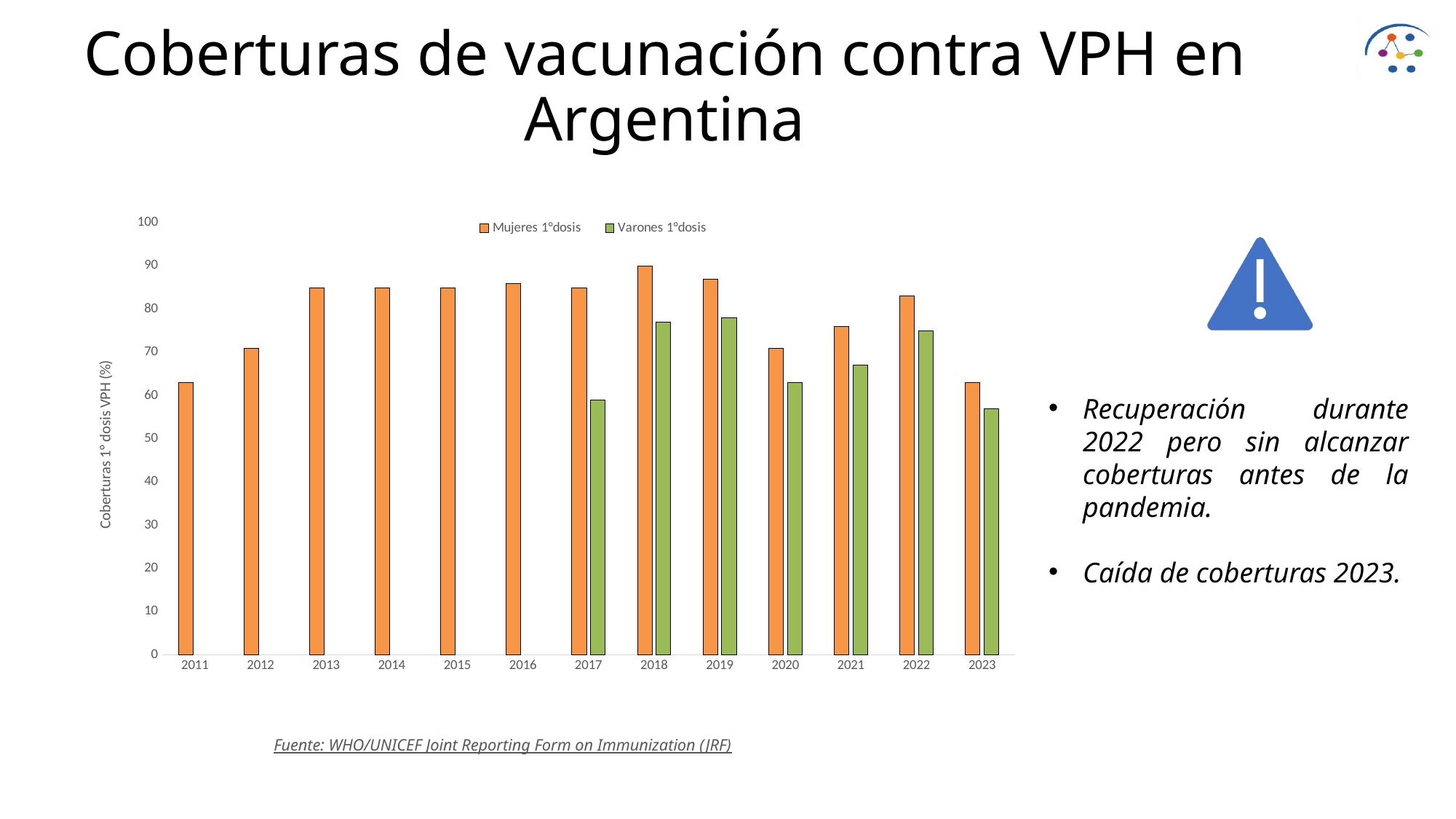
Is the Varones 1°dosis value for 2017 greater or less than 50? greater In 2022, which series has the larger value, Mujeres 1°dosis or Varones 1°dosis? Mujeres 1°dosis What kind of chart is shown on the slide? bar chart How many years are shown on the x axis? 13 Is the Mujeres 1°dosis value for 2018 greater or less than 80? greater Is the Mujeres 1°dosis value for 2011 greater or less than 70? less What is the first year for which a Varones 1°dosis bar is shown? 2017 How many series does the legend list? 2 In which year is the Mujeres 1°dosis coverage highest? 2018 Does the Mujeres 1°dosis coverage rise or fall from 2022 to 2023? fall For Varones 1°dosis, which year has the larger value, 2018 or 2020? 2018